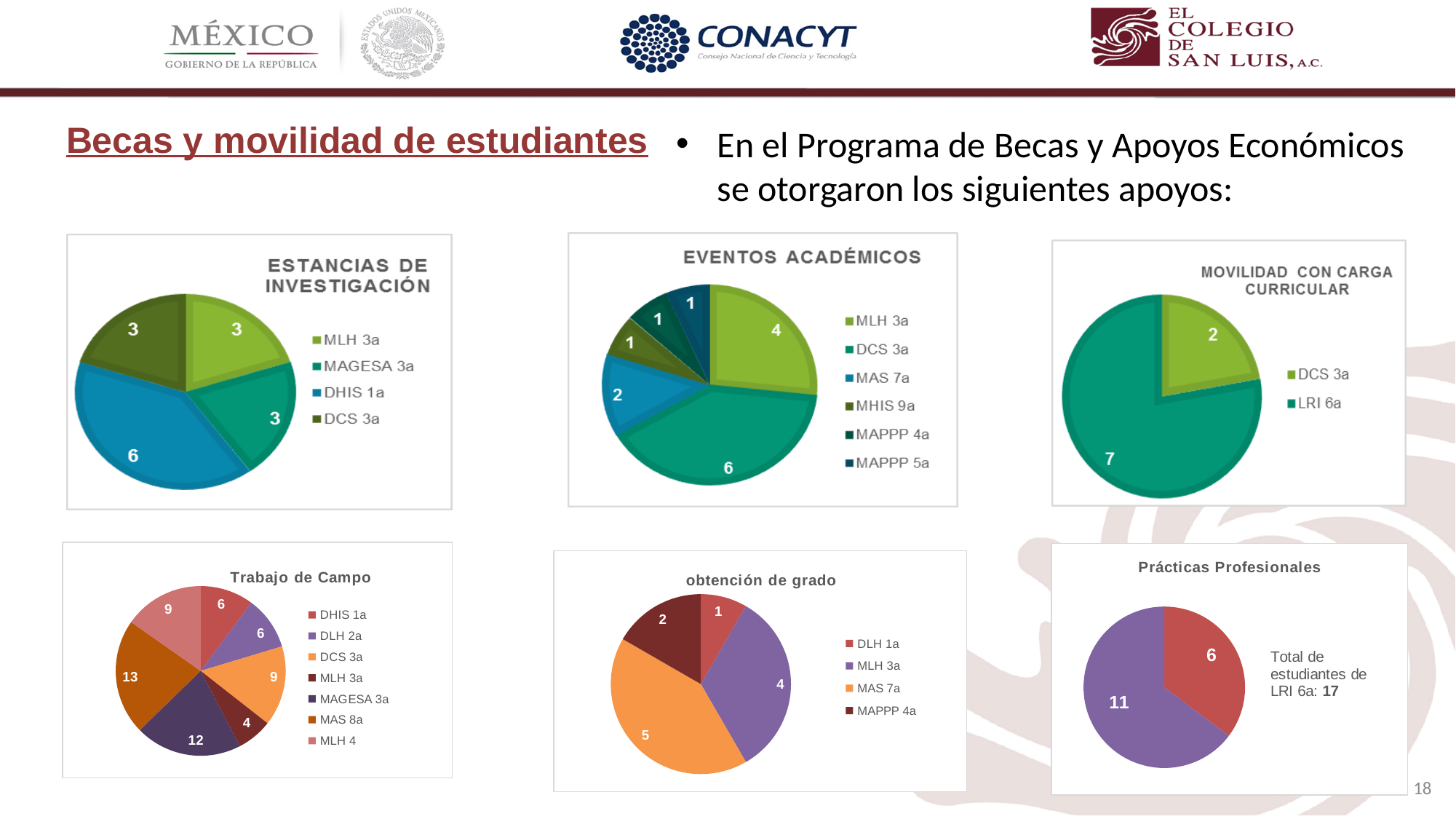
In the EVENTOS ACADÉMICOS chart, what is the value for DCS 3a? 6 In the Trabajo de Campo chart, which category has the highest value? MAS 8a In the obtención de grado chart, what is the value for MAS 7a? 5 In the ESTANCIAS DE INVESTIGACIÓN chart, what is the value for DHIS 1a? 6 In the MOVILIDAD CON CARGA CURRICULAR chart, what is the value for LRI 6a? 7 In the Trabajo de Campo chart, which category has the lowest value? MLH 3a In the MOVILIDAD CON CARGA CURRICULAR chart, which is larger, DCS 3a or LRI 6a? LRI 6a In the Trabajo de Campo chart, what is the value for MAGESA 3a? 12 In the ESTANCIAS DE INVESTIGACIÓN chart, which category has the largest slice? DHIS 1a What kind of chart is the Prácticas Profesionales chart? Pie chart In the EVENTOS ACADÉMICOS chart, how many categories does the legend list? 6 In the EVENTOS ACADÉMICOS chart, what is the difference between MLH 3a and MAS 7a? 2